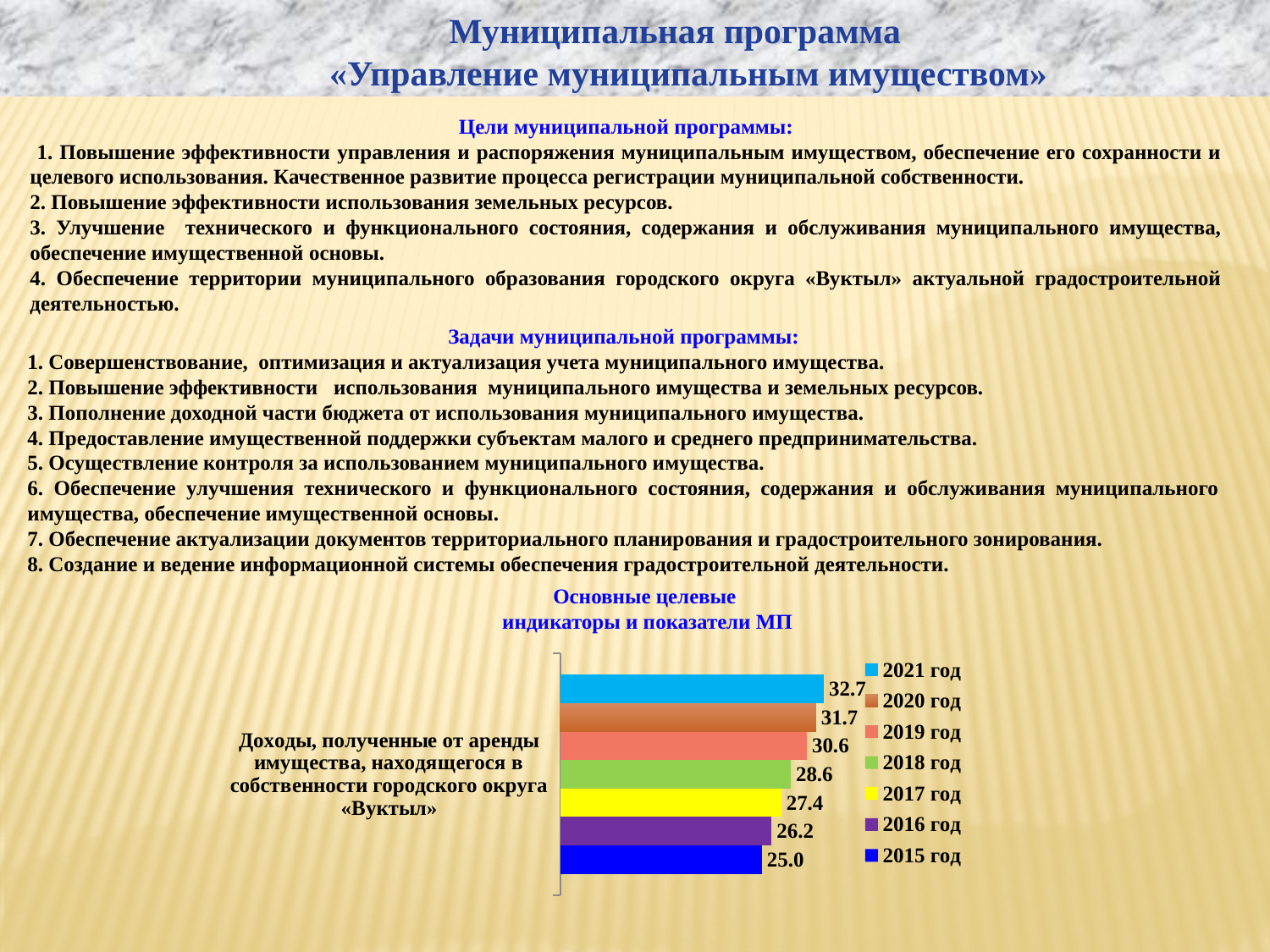
Какой год имеет наименьшее значение на диаграмме? 2015 год Какое значение показано для 2021 года на диаграмме «Доходы, полученные от аренды имущества»? 32.7 Какое значение показано для 2018 года на диаграмме? 28.6 На сколько значение 2021 года больше значения 2015 года? 7.7 Сколько лет (серий) перечислено в легенде диаграммы? 7 На сколько значение 2019 года больше значения 2016 года? 4.4 Какое значение показано для 2015 года на диаграмме? 25.0 Как изменяются значения от 2015 года к 2021 году: растут или падают? Растут Какого типа диаграмма показана на слайде? Столбчатая (линейчатая) диаграмма Что больше: значение 2020 года или значение 2018 года? 2020 год Какое значение показано для 2017 года на диаграмме? 27.4 Какой год имеет наибольшее значение на диаграмме? 2021 год